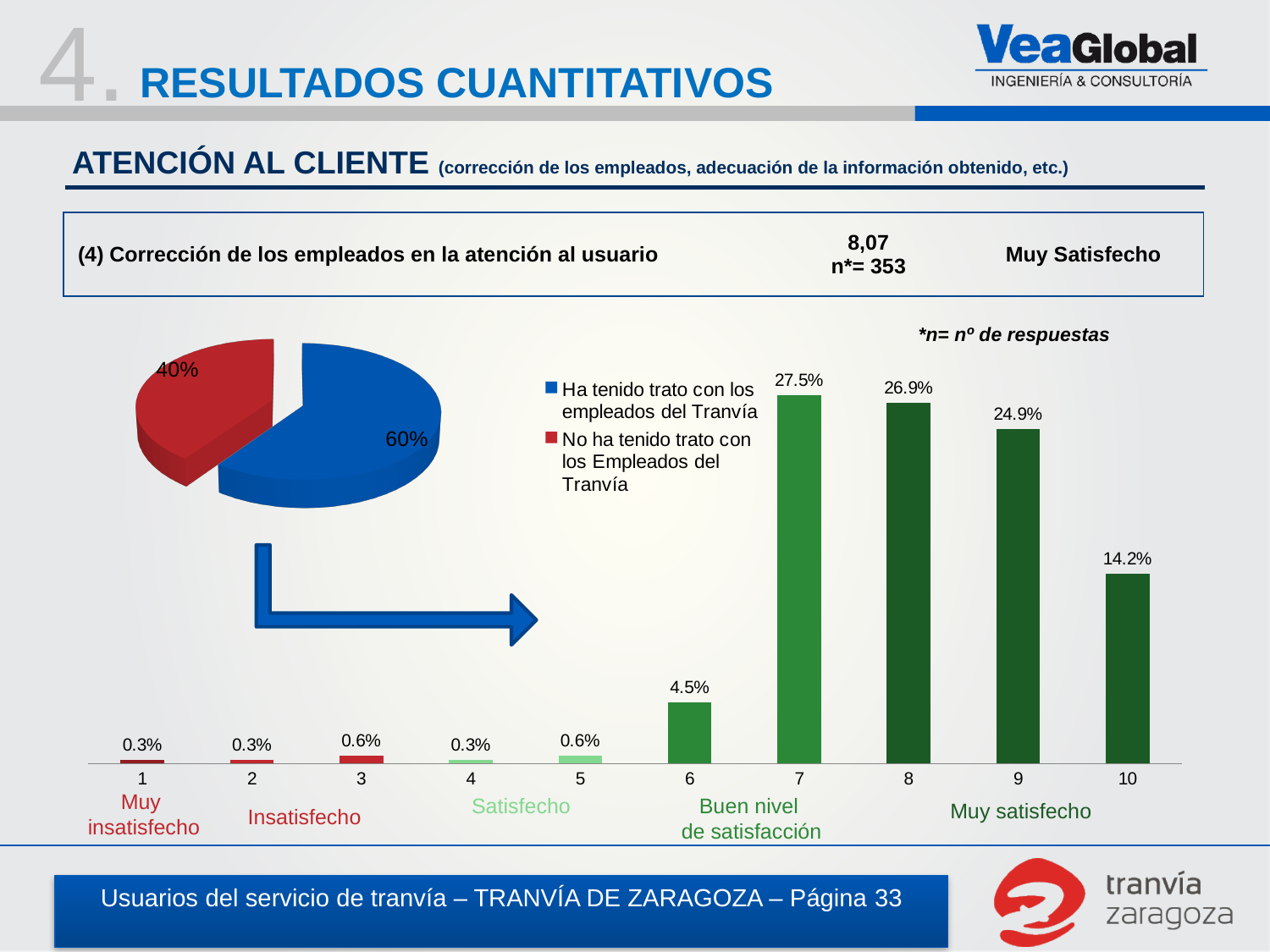
In the bar chart on the right, what is the difference between the values for category 7 and category 8? 0.6% In the bar chart on the right, which is larger: the value for category 9 or the value for category 10? Category 9 In the bar chart on the right, which category has the highest value? 7 In the bar chart on the right, what is the value for category 10? 14.2% In the bar chart on the right, how many categories are shown on the x axis? 10 In the pie chart on the left, what share corresponds to 'No ha tenido trato con los Empleados del Tranvía'? 40% In the pie chart on the left, what share corresponds to 'Ha tenido trato con los empleados del Tranvía'? 60% In the bar chart on the right, what is the value for category 7? 27.5% What kind of chart is the chart on the right of the slide showing categories 1 to 10? Bar chart How many entries does the legend of the pie chart on the left list? 2 In the bar chart on the right, what is the value for category 6? 4.5% What kind of chart is the chart on the left of the slide? Pie chart